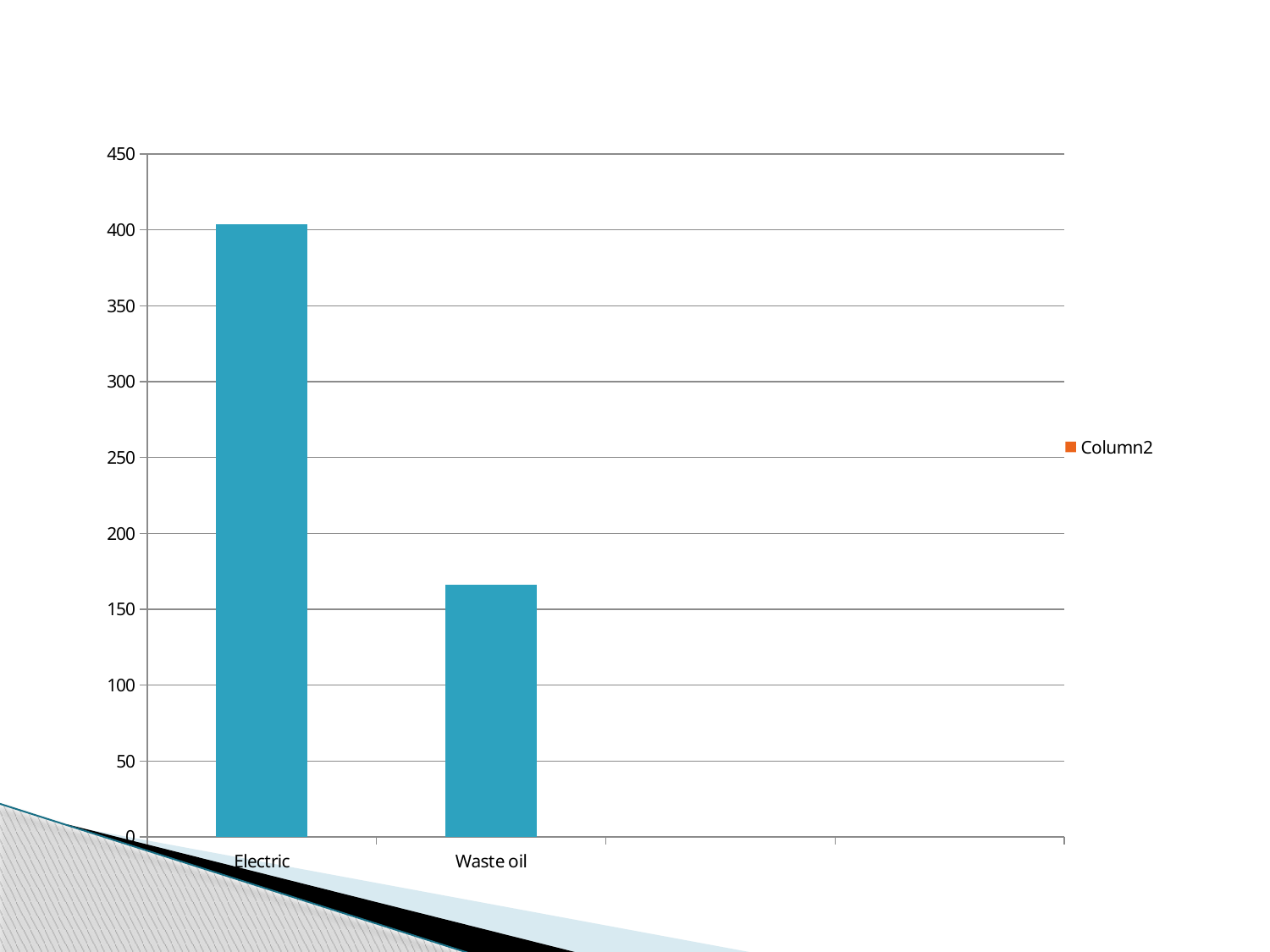
Which is larger, the value for Electric or the value for Waste oil? Electric Is the value for Electric greater or less than 350? greater What is the name of the series shown in the legend? Column2 What kind of chart is shown on the slide? bar chart Is the value for Waste oil greater or less than 150? greater Which category has the lowest value? Waste oil Is the value for Electric greater or less than 450? less How many series does the legend list? 1 Which category has the highest value? Electric How many bars are plotted on the chart? 2 Do the values rise or fall from Electric to Waste oil along the x axis? fall